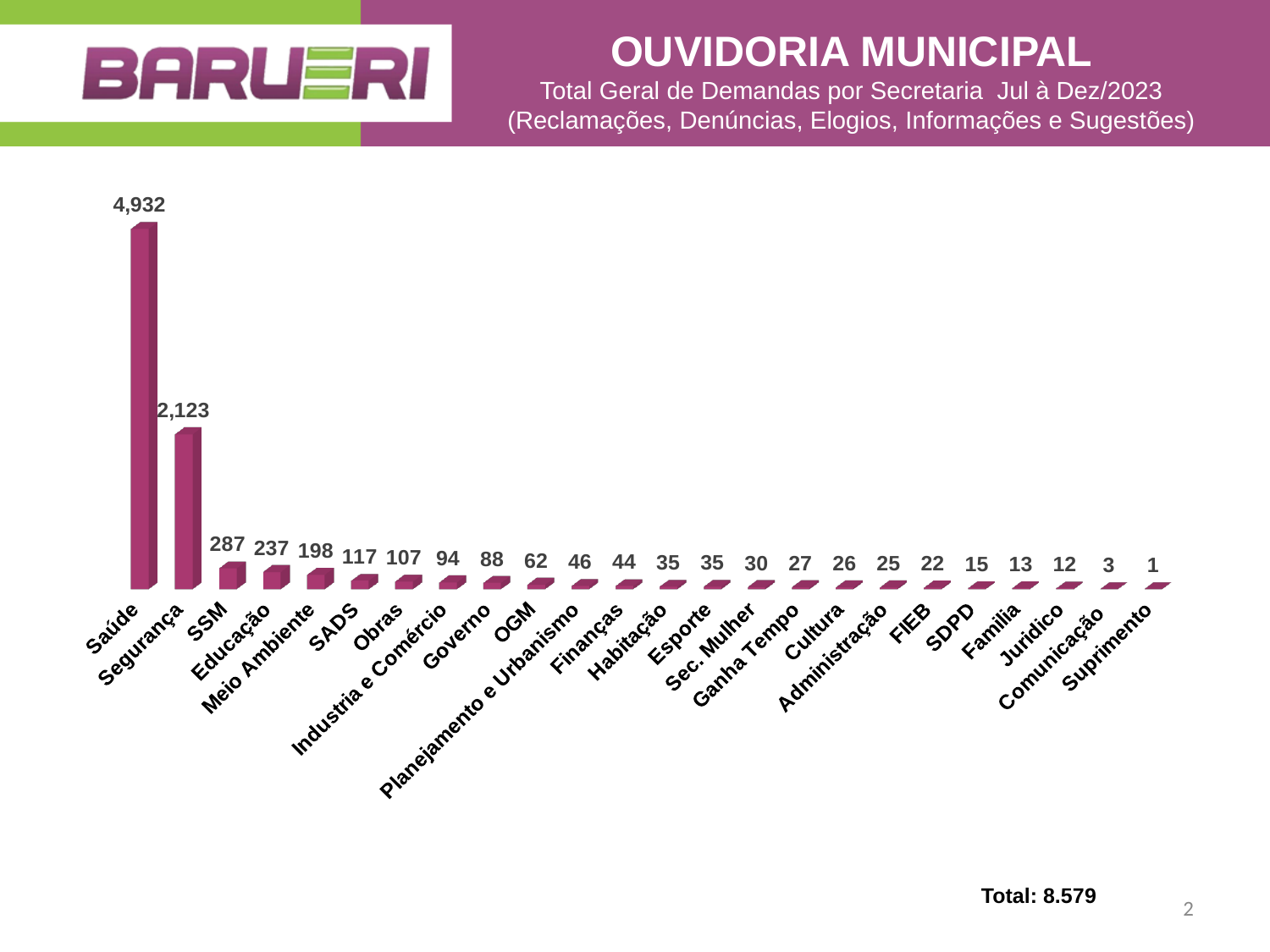
What is the value for Planejamento e Urbanismo? 46 What is the difference between the values for SSM and Educação? 50 What is the value for Meio Ambiente? 198 Which category has the lowest value? Suprimento Which is larger, the value for Obras or the value for Governo? Obras Which category has the highest value? Saúde What is the value for Segurança? 2,123 What total is printed at the bottom of the slide? 8.579 What is the value for Saúde? 4,932 How many categories are shown in the chart? 24 What kind of chart is shown on the slide? Bar chart What is the difference between the values for Saúde and Segurança? 2,809